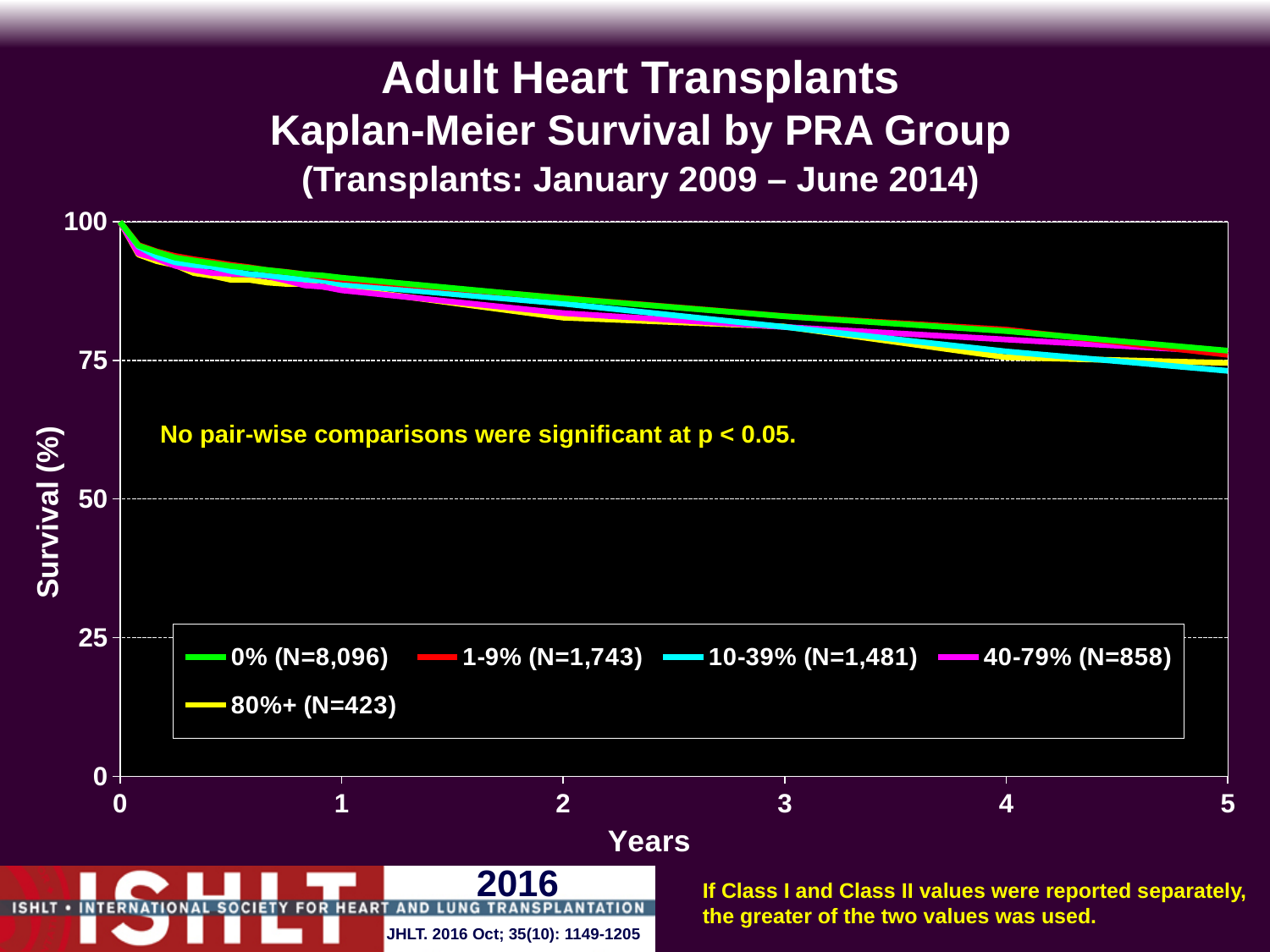
Which PRA group has the largest number of patients (N) according to the legend? 0% (N=8,096) What kind of chart is shown on the slide? Line chart How many tick marks are labelled on the Years axis? 6 How many PRA groups (series) does the legend list? 5 Is the survival value for the 10-39% PRA group at 5 years greater or less than 50? greater What colour is the line for the 80%+ PRA group? Yellow Do the survival curves rise or fall as the years increase? Fall Is the survival value for the 40-79% PRA group at 2 years greater or less than 75? greater Is the survival value for the 0% PRA group at 1 year greater or less than 75? greater